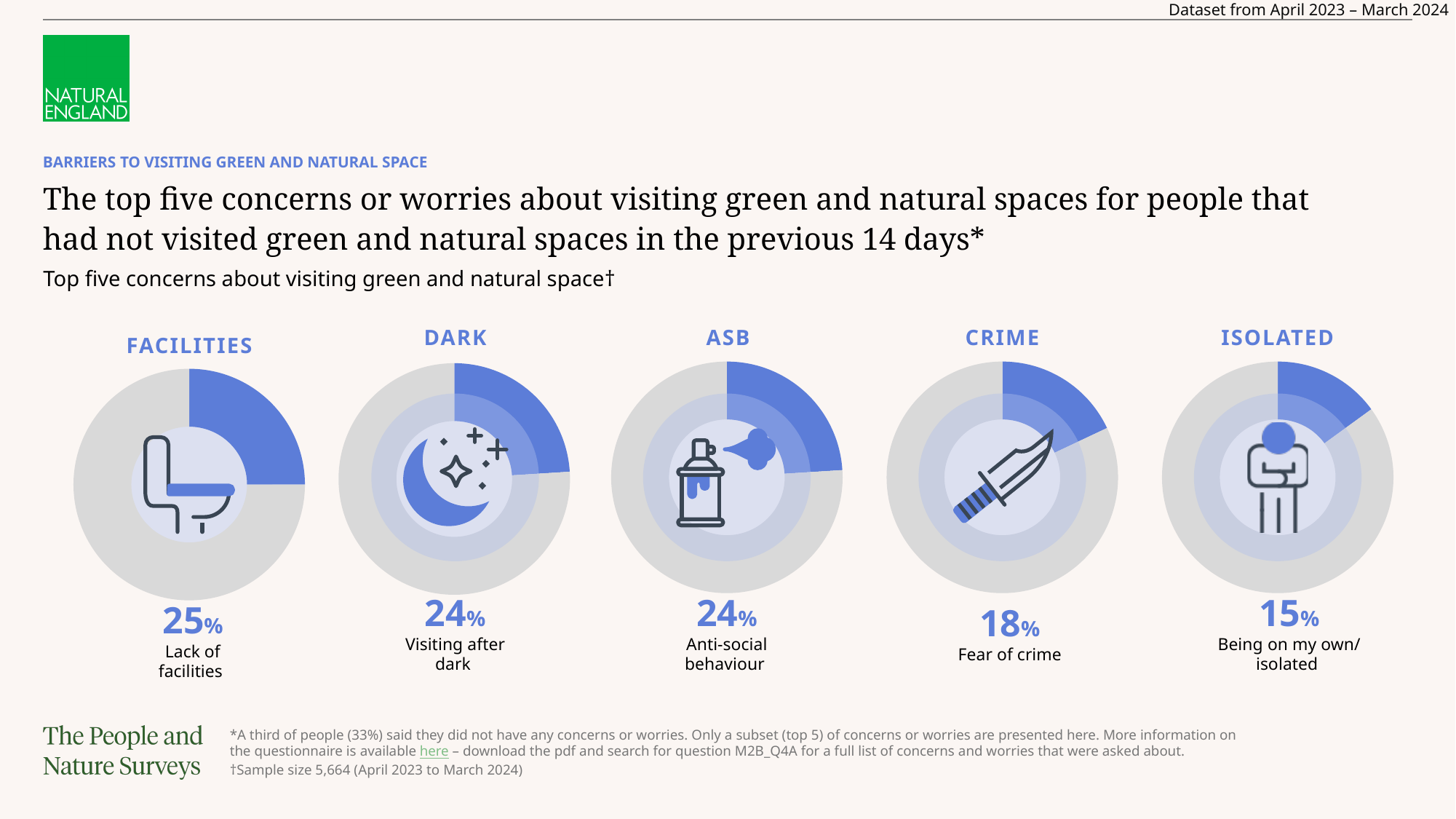
What is the value shown for being on my own/isolated? 15% Which of the five concerns has the highest percentage? Lack of facilities What is the difference in percentage points between lack of facilities and fear of crime? 7 What percentage of people cited fear of crime as a concern? 18% Which is larger, the value for fear of crime or the value for being on my own/isolated? Fear of crime What percentage of people cited lack of facilities as a concern about visiting green and natural spaces? 25% What is the value shown for the DARK (visiting after dark) concern? 24% Which of the five concerns has the lowest percentage? Being on my own/isolated What kind of chart is used to show each concern? Donut chart What is the subtitle of the chart section on the slide? Top five concerns about visiting green and natural space How many concerns are shown on the slide? 5 What percentage is shown for anti-social behaviour (ASB)? 24%